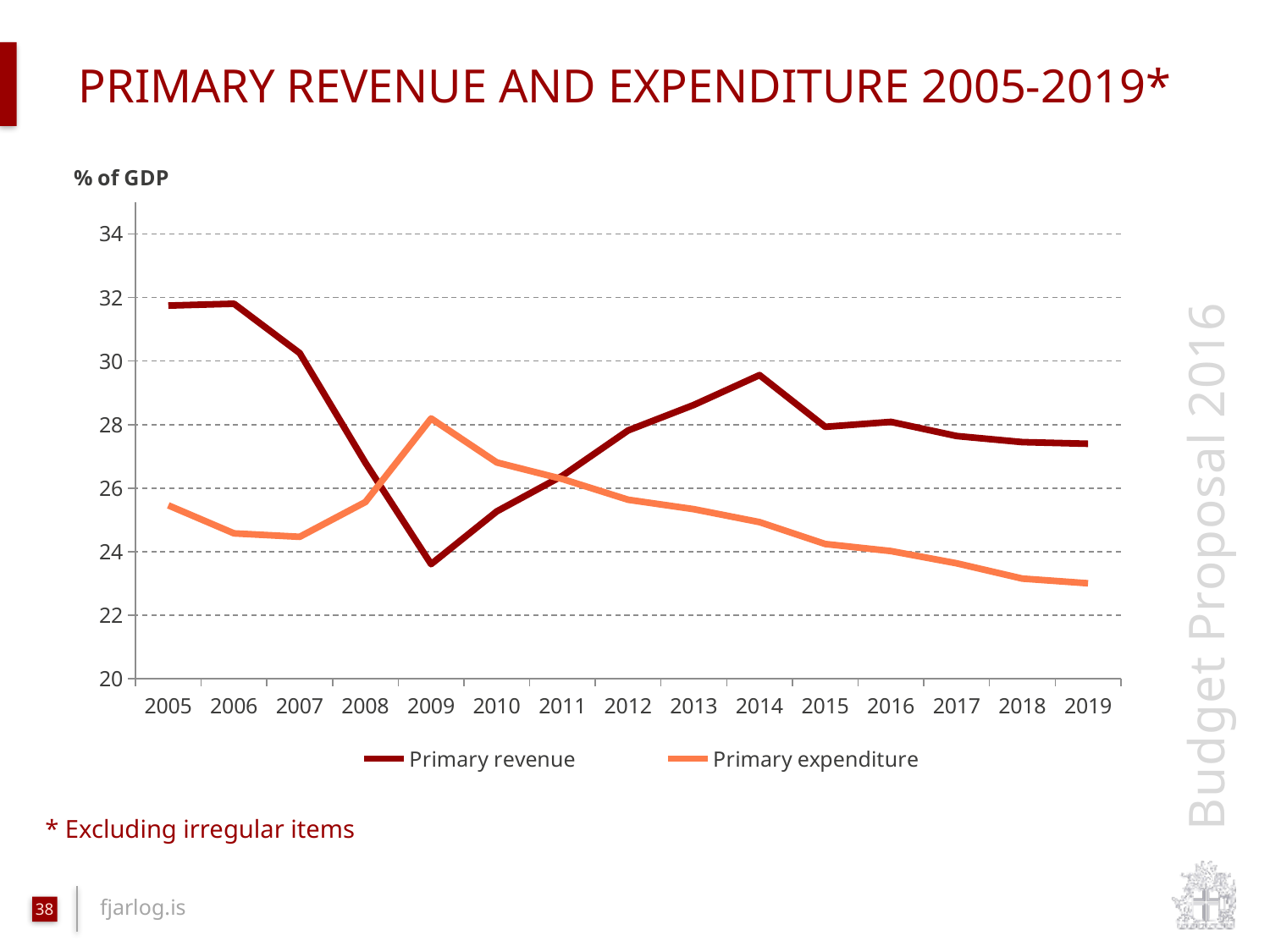
In which year is Primary revenue at its lowest? 2009 In 2009, which series has the larger value, Primary revenue or Primary expenditure? Primary expenditure In which year is Primary expenditure at its highest? 2009 Is the value for Primary revenue in 2009 greater or less than 24? less Is the value for Primary expenditure in 2019 greater or less than 24? less What unit is shown as the label above the y axis? % of GDP Does Primary expenditure rise or fall from 2009 to 2019? Fall Is the value for Primary revenue in 2014 greater or less than 28? greater How many years are plotted along the x axis? 15 How many series does the legend list? 2 What kind of chart is shown on the slide? Line chart